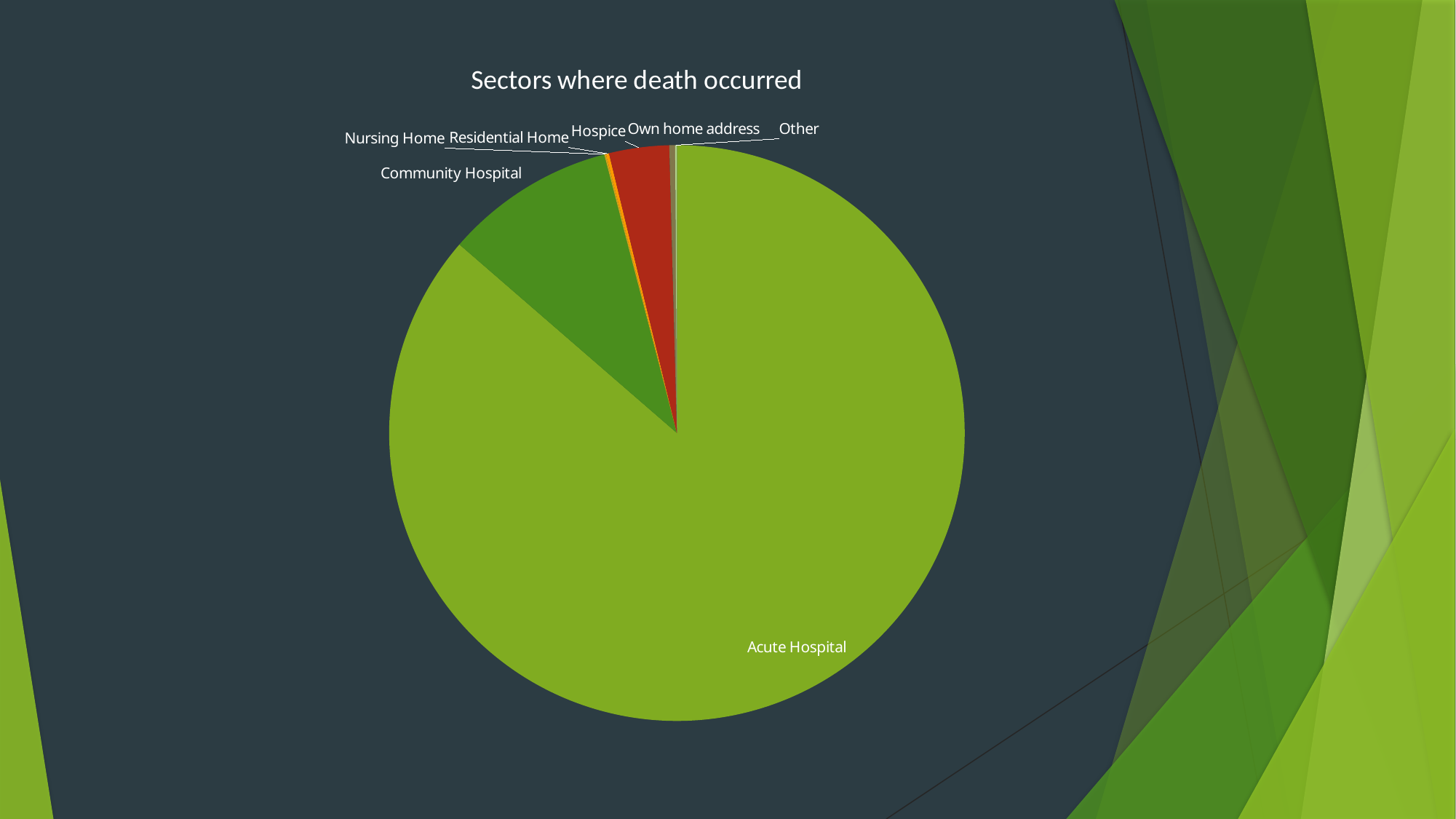
What is the title of the chart? Sectors where death occurred Which slice is larger, Community Hospital or Residential Home? Community Hospital What colour is the Hospice slice? Red Which slice is larger, Community Hospital or Hospice? Community Hospital How many sectors (slices) are labelled in the pie chart? 7 Which sector has the second-largest slice of the pie? Community Hospital Which sector has the largest slice of the pie? Acute Hospital Which slice is larger, Acute Hospital or Community Hospital? Acute Hospital What kind of chart is shown on the slide? Pie chart